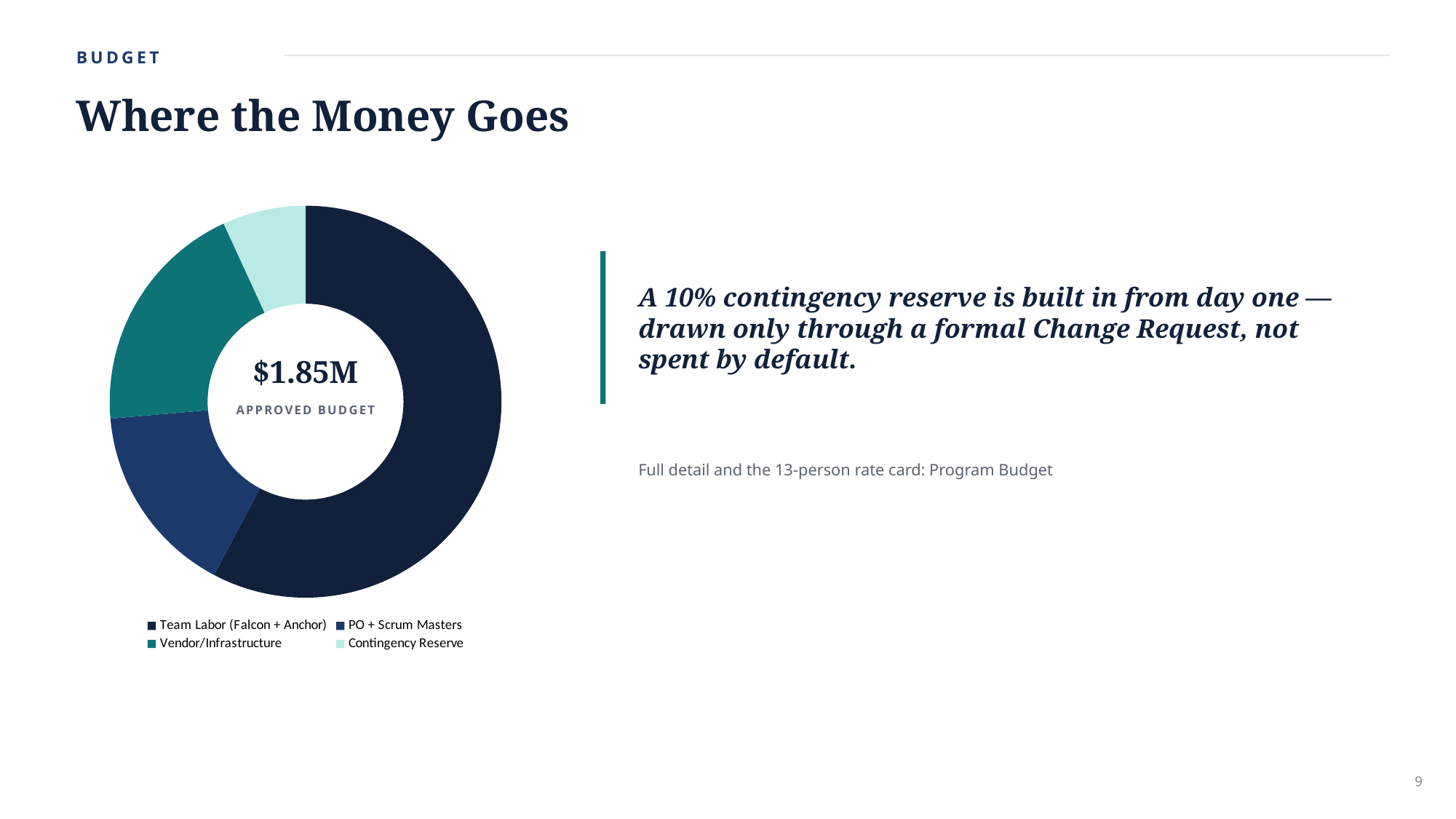
Which category has the largest slice of the pie chart? Team Labor (Falcon + Anchor) What total approved budget is shown in the centre of the donut chart? $1.85M How many categories does the pie chart show? 4 Which slice is larger: PO + Scrum Masters or Contingency Reserve? PO + Scrum Masters Which slice is larger: Vendor/Infrastructure or Contingency Reserve? Vendor/Infrastructure Which category is shown in the lightest (mint) colour in the legend? Contingency Reserve Does Team Labor (Falcon + Anchor) account for more or less than half of the pie chart? More Which category has the smallest slice of the pie chart? Contingency Reserve What kind of chart is shown on the slide? Pie chart (donut)